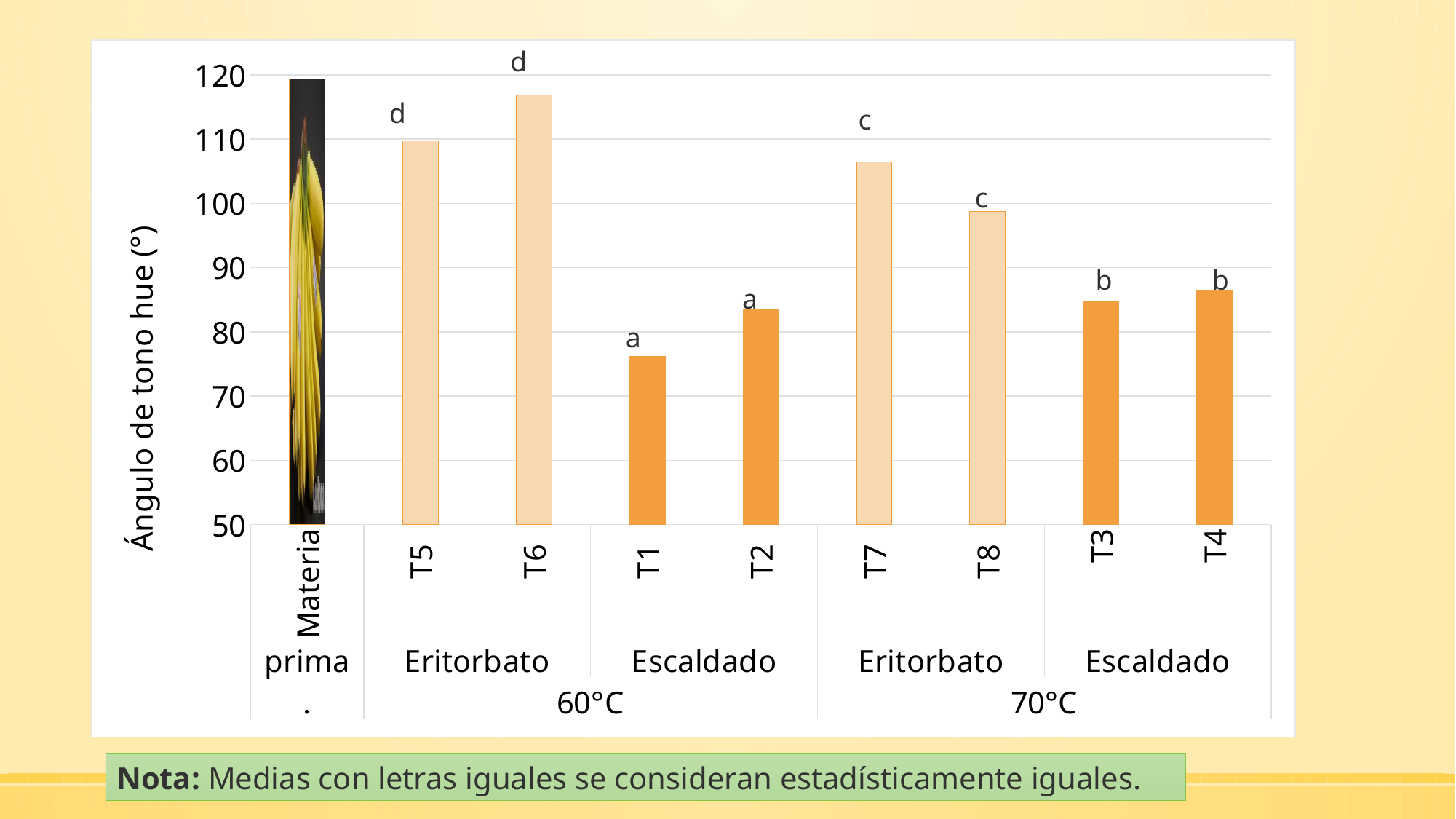
Is the value for T1 greater or less than 80? less Which has a larger hue angle, T5 or T6? T6 Which treatment bar (T1–T8) has the highest hue angle? T6 Which treatment bar (T1–T8) has the lowest hue angle? T1 What letter is printed above the T7 bar? c How many bars are plotted in the chart? 9 What is the title of the vertical axis? Ángulo de tono hue (°) What kind of chart is shown on the slide? bar chart Which has a larger hue angle, T1 or T2? T2 Is the value for T5 greater or less than 100? greater Is the value for T3 greater or less than 90? less